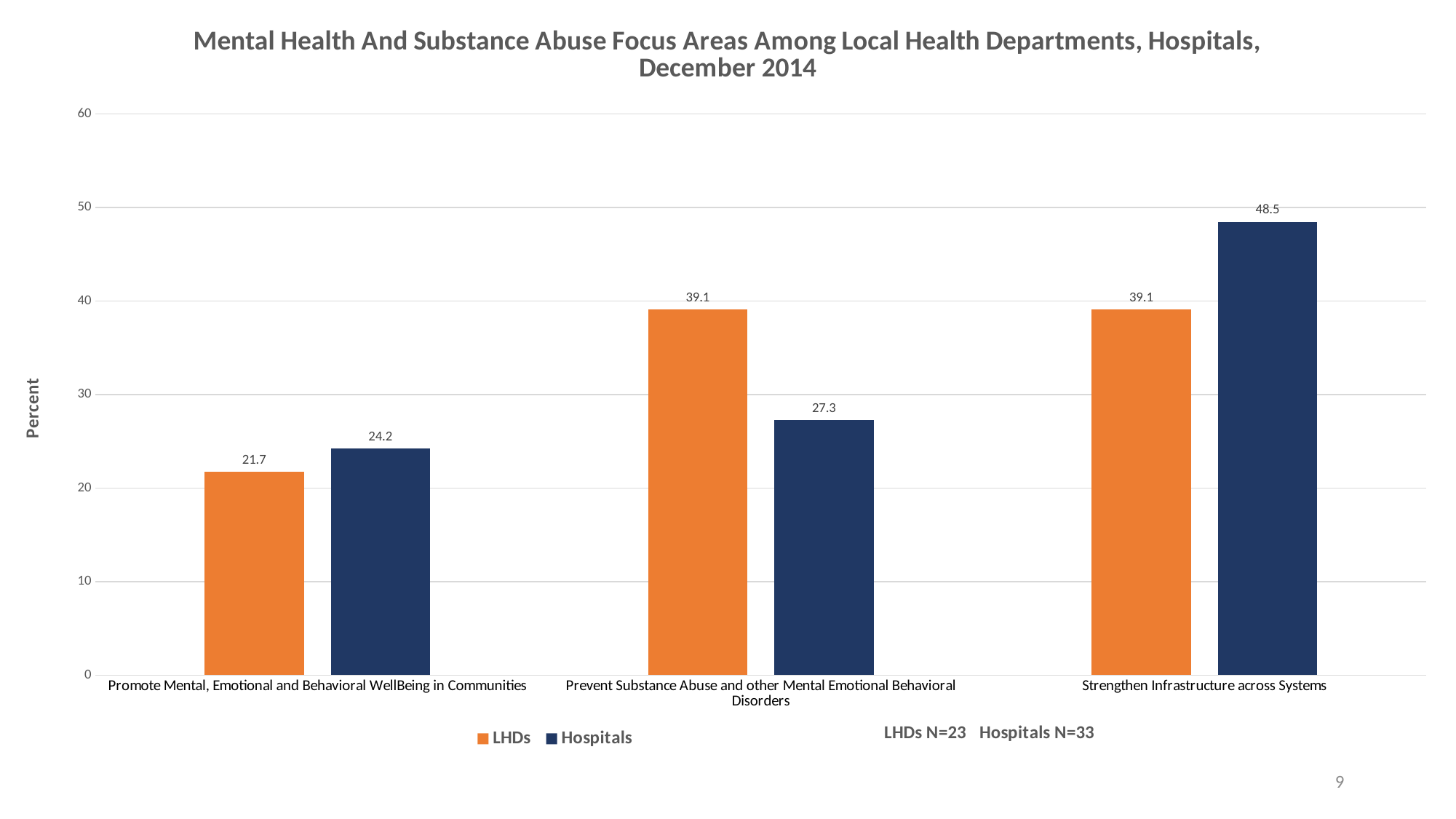
Which focus area has the highest Hospitals value? Strengthen Infrastructure across Systems What kind of chart is shown on the slide? Bar chart What is the label on the vertical axis? Percent Which focus area has the lowest LHDs value? Promote Mental, Emotional and Behavioral WellBeing in Communities For Prevent Substance Abuse and other Mental Emotional Behavioral Disorders, which series has the larger value, LHDs or Hospitals? LHDs What is the Hospitals value for Strengthen Infrastructure across Systems? 48.5 Is the Hospitals value for Promote Mental, Emotional and Behavioral WellBeing in Communities greater or less than 30? less What is the LHDs value for Promote Mental, Emotional and Behavioral WellBeing in Communities? 21.7 How many focus area categories are shown on the x axis? 3 What is the Hospitals value for Prevent Substance Abuse and other Mental Emotional Behavioral Disorders? 27.3 How many series does the legend list? 2 What is the difference between the Hospitals and LHDs values for Strengthen Infrastructure across Systems? 9.4